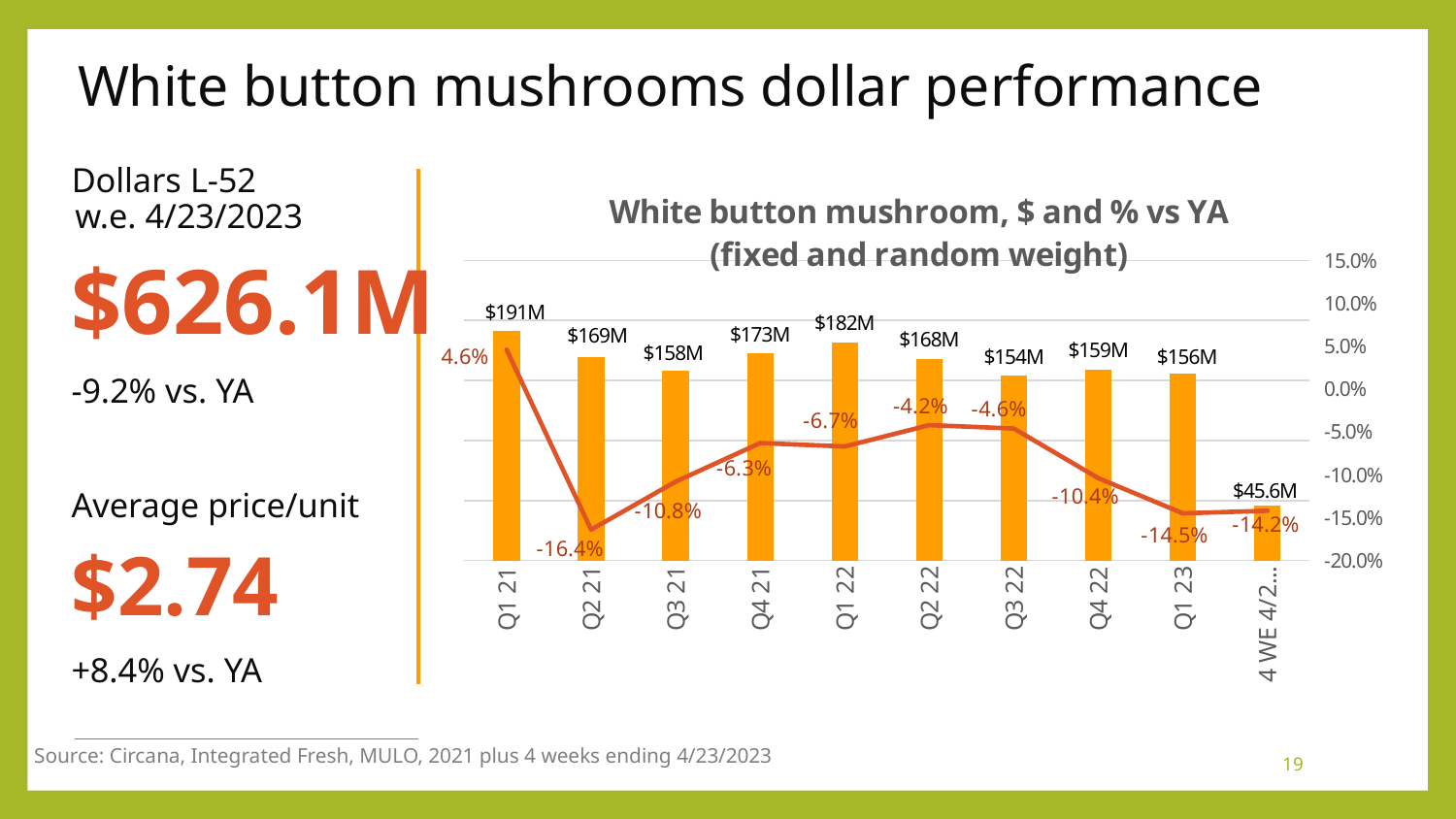
What is the % vs YA value shown for Q2 21? -16.4% Do the dollar value bars rise or fall from Q1 21 to Q3 21? Fall What is the title of the chart? White button mushroom, $ and % vs YA (fixed and random weight) What is the difference in dollar value between Q1 21 and Q2 21? $22M What is the % vs YA value shown for Q4 22? -10.4% Which has the larger dollar value, Q4 21 or Q2 22? Q4 21 Which period has the lowest % vs YA value on the line? Q2 21 What kind of chart is shown on the slide? Combination bar and line chart What is the dollar value shown for Q3 22? $154M How many periods are shown on the x axis of the chart? 10 What is the dollar value shown for Q1 22? $182M Which quarter has the highest dollar value bar? Q1 21